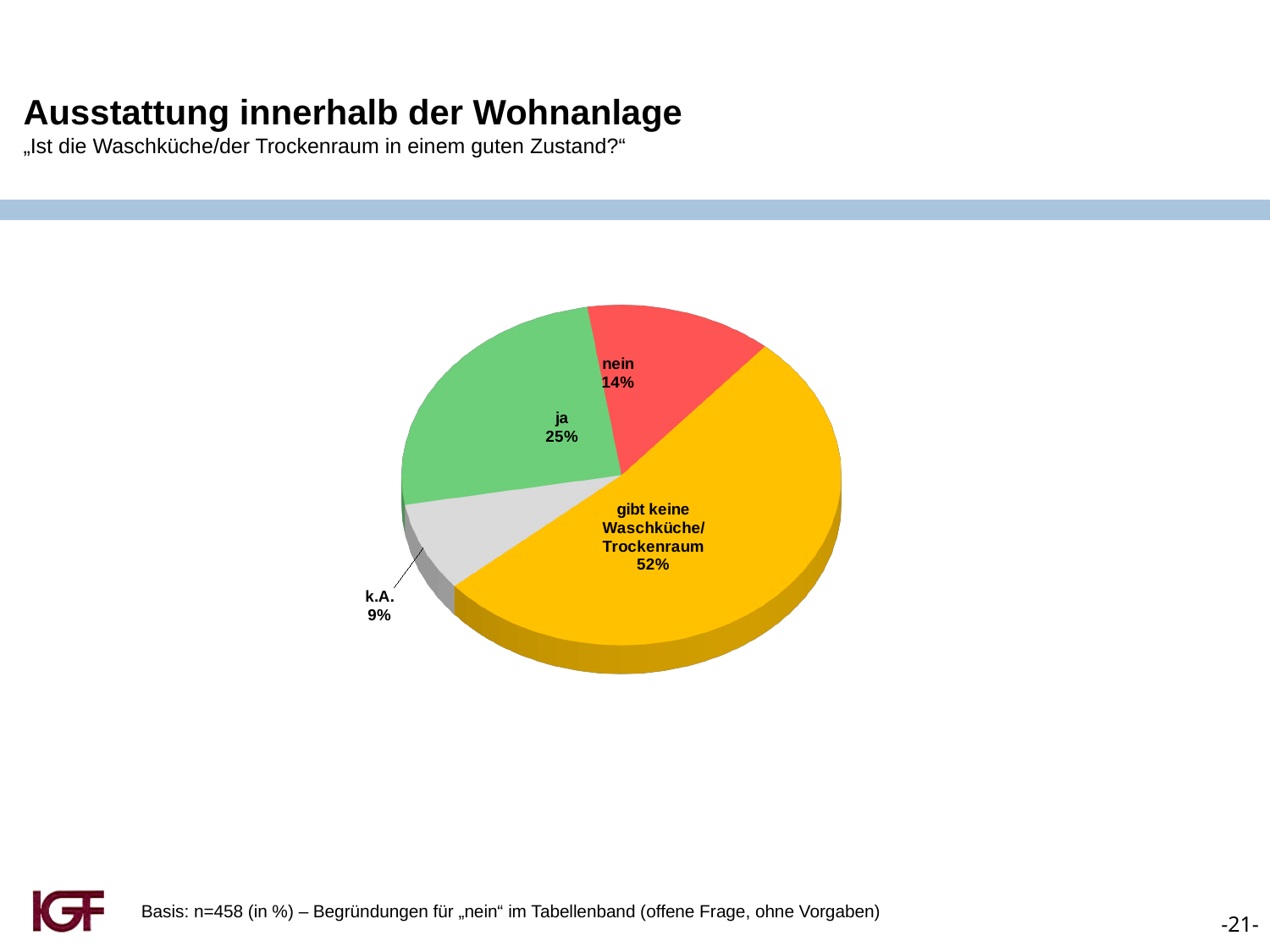
What is the combined percentage of "ja" and "nein" responses? 39% What colour is the slice for "gibt keine Waschküche/Trockenraum"? yellow What share of the pie is labelled "gibt keine Waschküche/Trockenraum"? 52% What percentage of respondents answered "nein"? 14% What type of chart is shown on the slide? pie chart Which category has the largest slice of the pie? gibt keine Waschküche/Trockenraum What percentage is shown for "k.A."? 9% What percentage of respondents answered "ja"? 25% Which category has the smallest slice of the pie? k.A. How many slices does the pie chart have? 4 What is the difference in percentage points between "ja" and "nein"? 11 Which is larger, the share for "ja" or the share for "nein"? ja